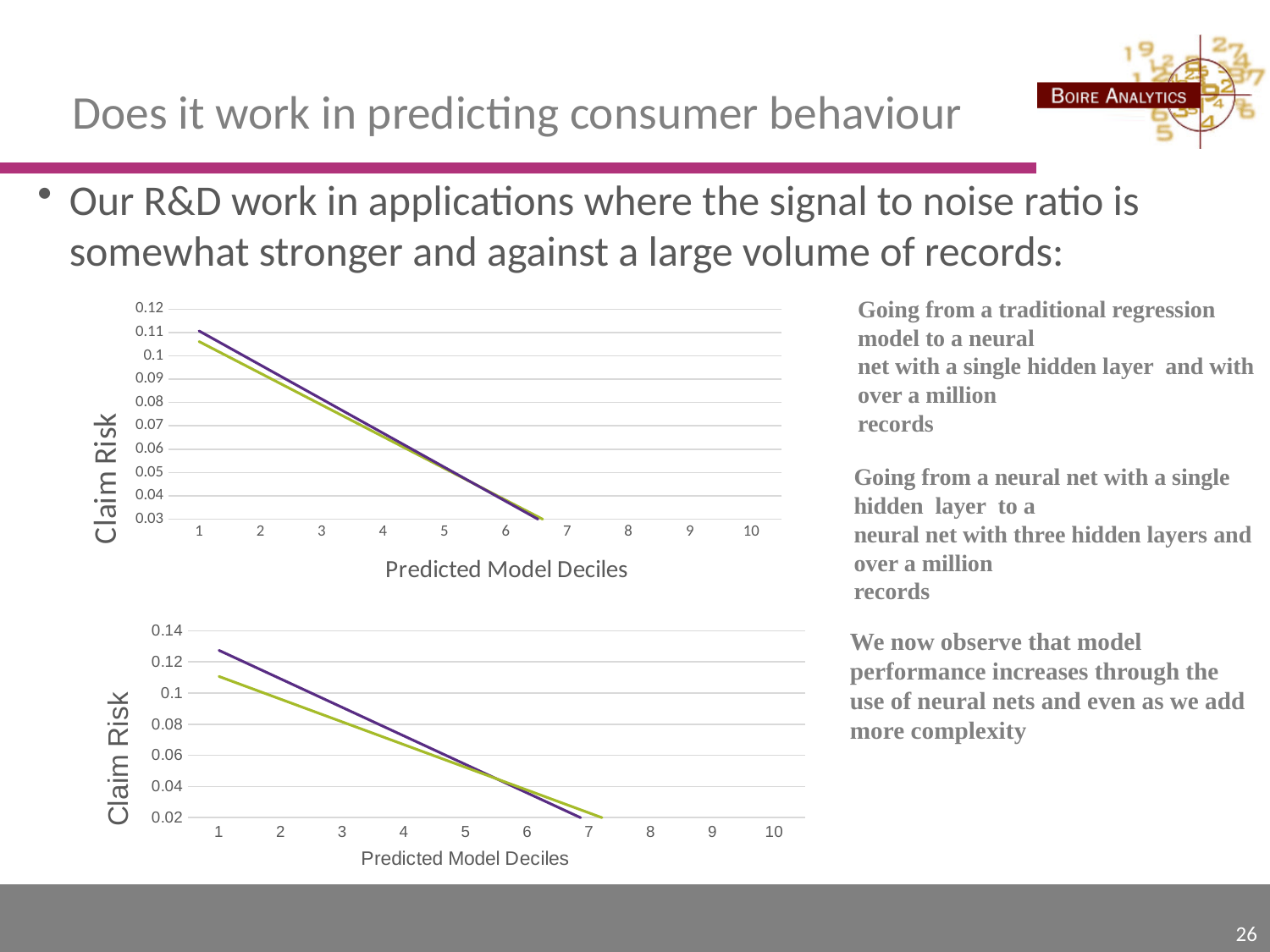
What kind of chart is the top chart on the slide? line chart In the top chart, do the values rise or fall as the predicted model decile increases? fall What is the label of the x axis on the bottom chart? Predicted Model Deciles In the bottom chart, is the value of the purple line at decile 3 greater or less than 0.1? less How many deciles are marked on the x axis of the top chart? 10 In the bottom chart, is the value of the green line at decile 1 greater or less than 0.12? less What is the label of the y axis on the top chart? Claim Risk How many deciles are marked on the x axis of the bottom chart? 10 In the bottom chart, do the values rise or fall as the predicted model decile increases? fall In the bottom chart, is the value of the purple line at decile 1 greater or less than 0.12? greater In the bottom chart, at decile 1, which line has the higher claim risk, the purple line or the green line? the purple line What kind of chart is the bottom chart on the slide? line chart